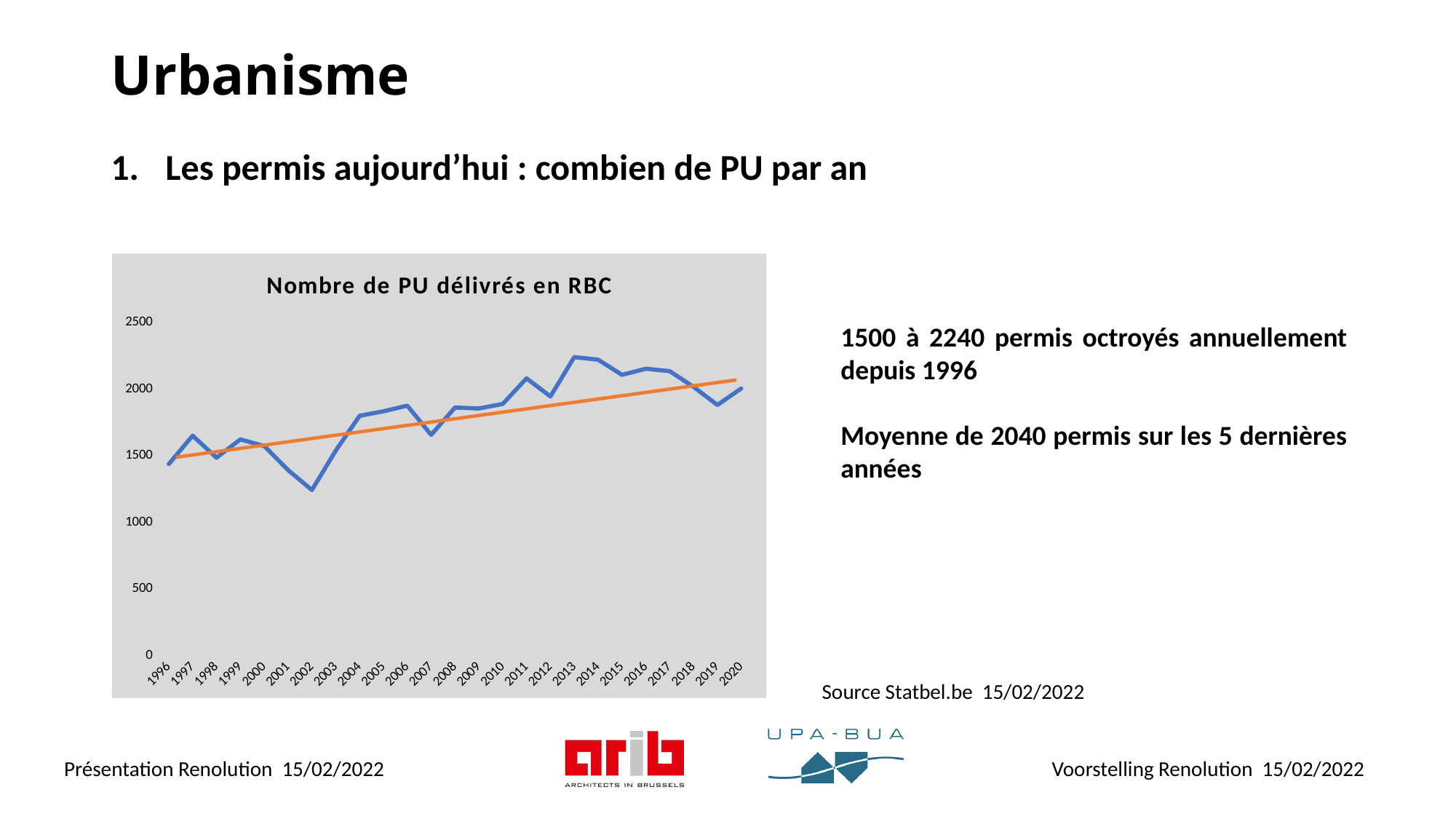
What is the title of the chart? Nombre de PU délivrés en RBC What is the highest value shown on the y axis of the chart? 2500 Is the value for 2016 greater or less than 2000? greater Is the value for 2013 greater or less than 2000? greater How many years are plotted along the x axis of the chart? 25 Which year has the larger value, 2002 or 2013? 2013 Which year has the lowest value on the chart? 2002 Is the value for 1996 greater or less than 1500? less Does the orange trend line rise or fall from 1996 to 2020? rise What kind of chart is shown on the slide? line chart